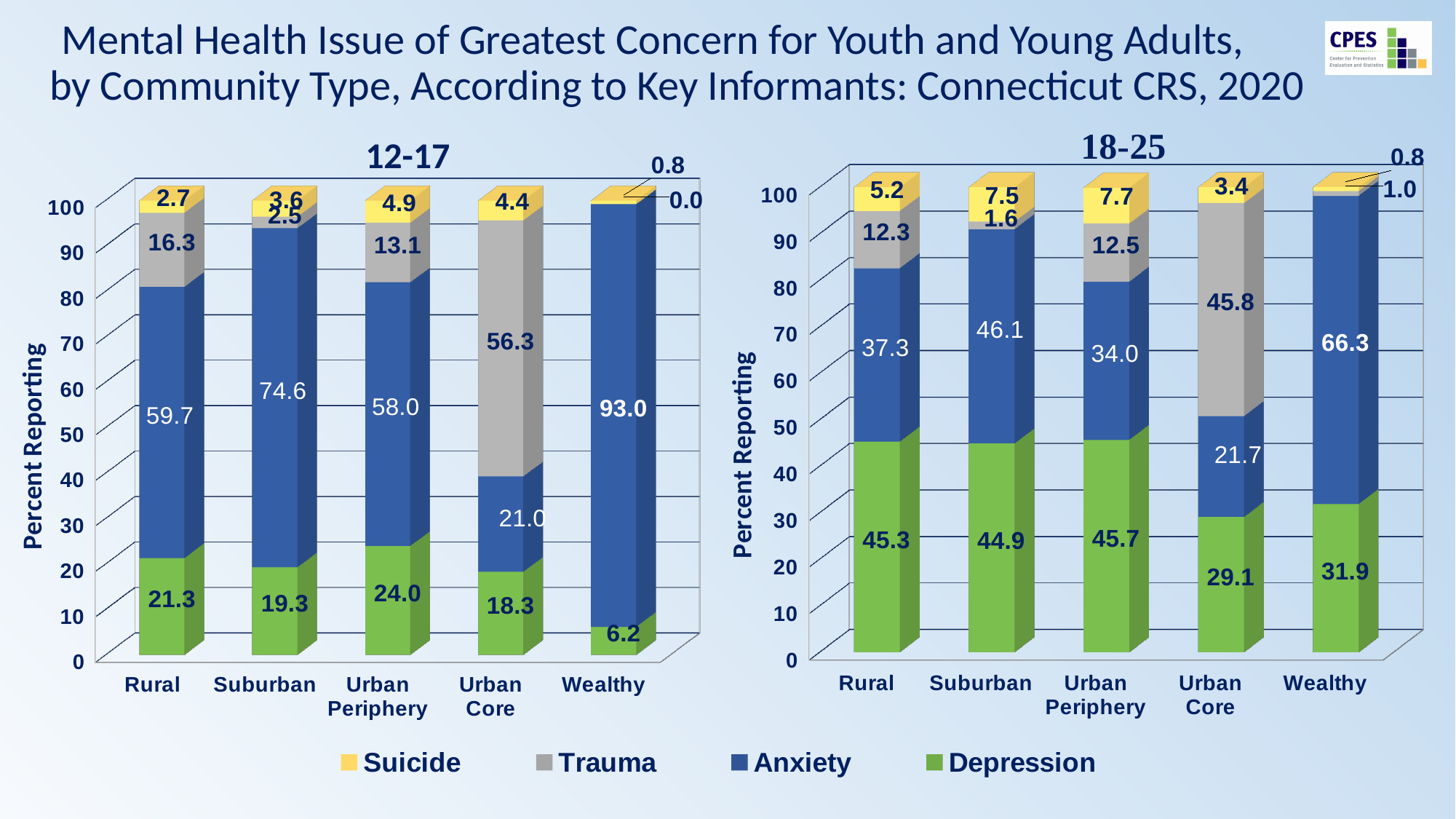
In the 12-17 chart, what is the Trauma value for Urban Core? 56.3 What kind of chart is the 18-25 chart? Stacked bar chart In the 12-17 chart, what is the Anxiety value for Wealthy communities? 93.0 In the 18-25 chart, what is the difference between the Trauma values for Urban Core and Rural? 33.5 How many community types are shown on the x axis of the 12-17 chart? 5 In the 12-17 chart, which community type has the lowest Depression value? Wealthy In the 18-25 chart, which community type has the highest Anxiety value? Wealthy In the 18-25 chart, is the Depression value for Urban Core greater or less than 30? less In the 12-17 chart, is the Anxiety value larger for Suburban or for Urban Periphery? Suburban How many series does the legend list? 4 Which colour represents Trauma in the legend? Gray In the 18-25 chart, what is the Depression value for Rural communities? 45.3